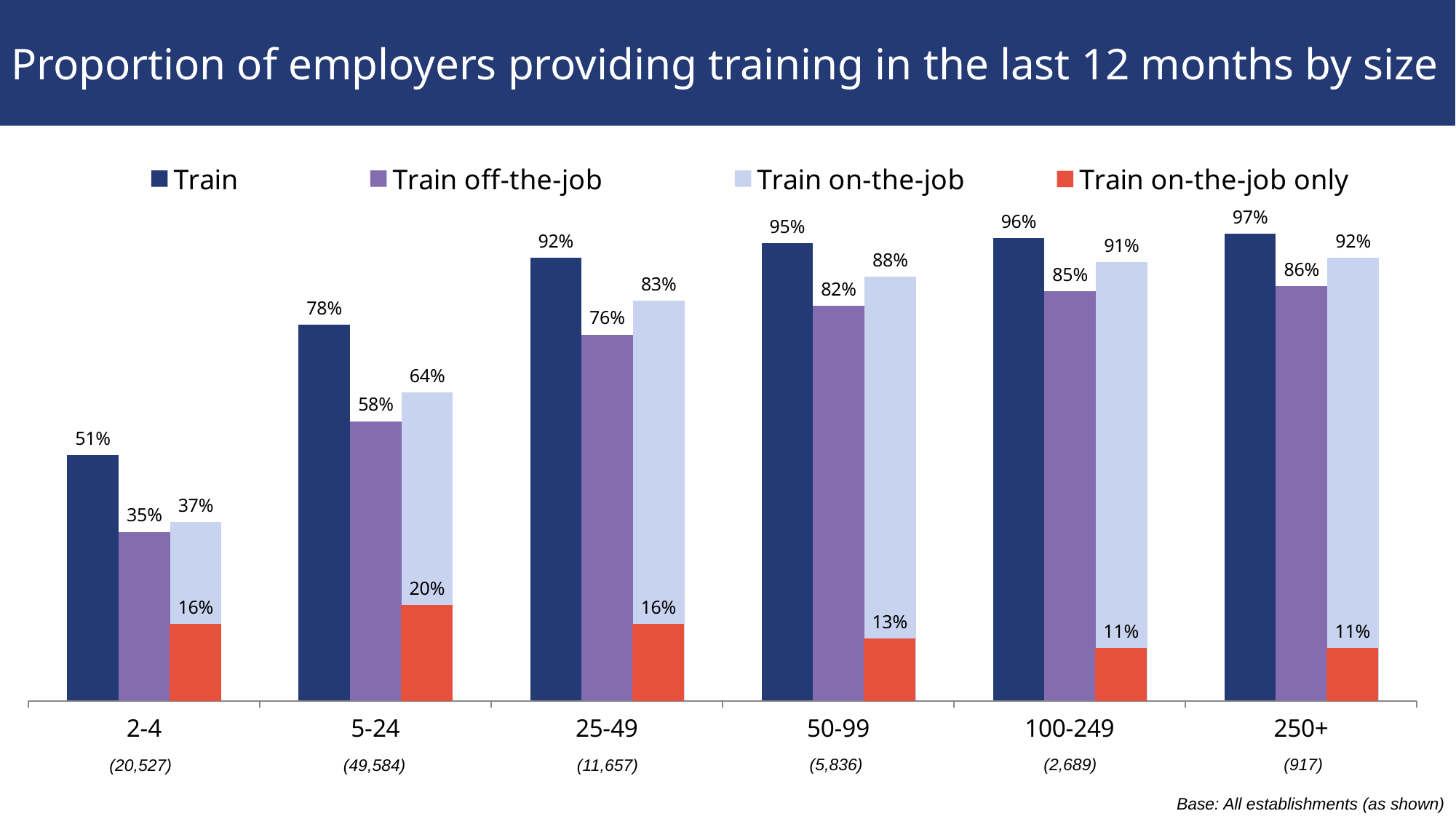
What is the difference between Train on-the-job and Train off-the-job for employers of size 25-49? 7% What is the base (number of establishments) shown for the 250+ size band? 917 Which is larger for employers of size 100-249: Train off-the-job or Train on-the-job? Train on-the-job Which size band has the highest value for Train? 250+ How many size bands are shown on the x axis? 6 Does the value for Train on-the-job only rise or fall from size 5-24 to size 250+? Fall What is the value for Train for employers of size 2-4? 51% What is the value for Train on-the-job only for employers of size 5-24? 20% Which size band has the lowest value for Train on-the-job? 2-4 How many series does the legend list? 4 What is the value for Train off-the-job for employers of size 50-99? 82% What kind of chart is shown on the slide? Bar chart